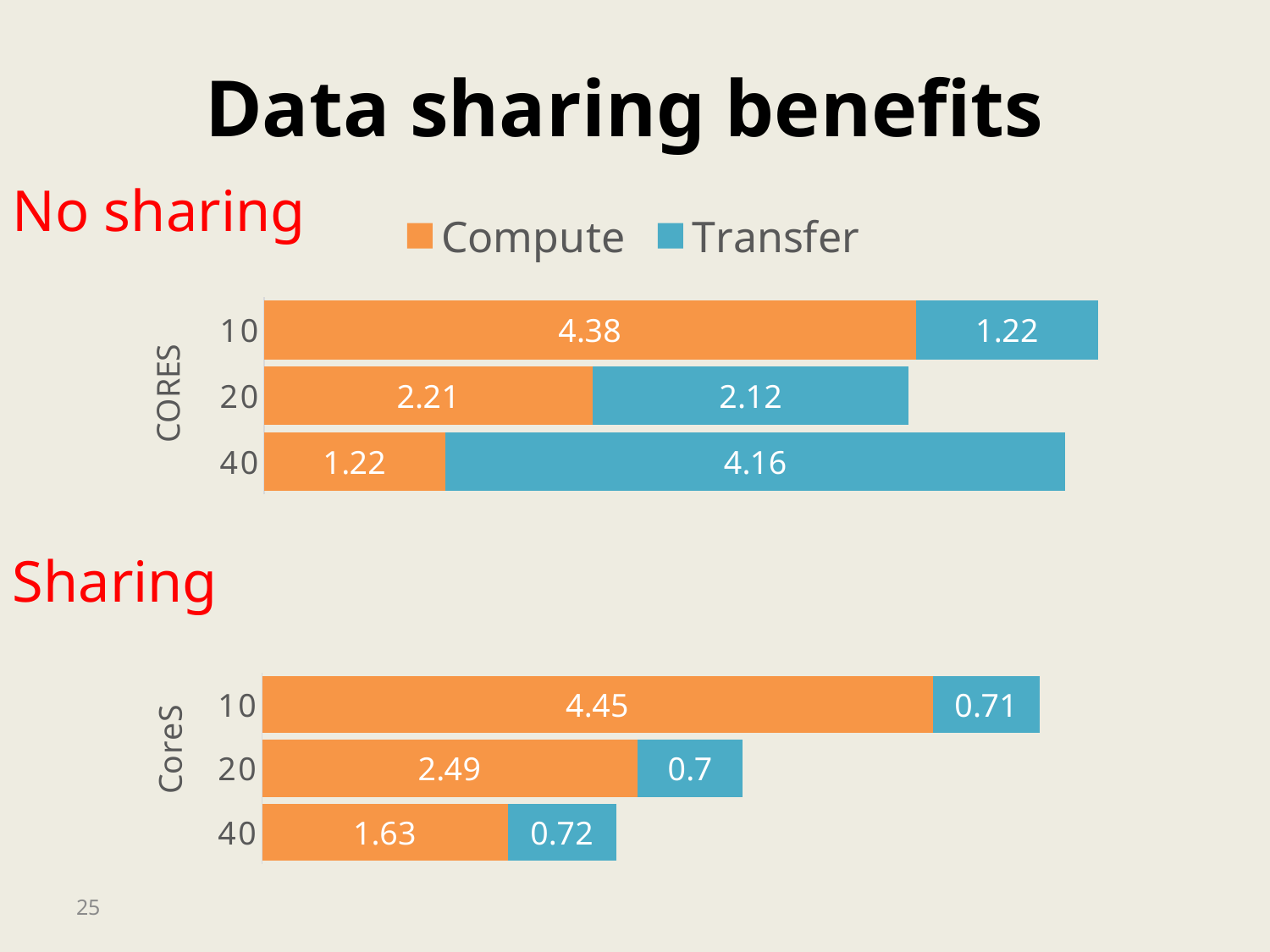
In the "No sharing" chart, is the Compute value for 20 cores larger or smaller than the Compute value for 40 cores? larger In the "No sharing" chart, what is the Transfer value for 40 cores? 4.16 In the "Sharing" chart, what is the Transfer value for 20 cores? 0.7 In the "No sharing" chart, what is the difference between the Transfer value for 40 cores and the Transfer value for 10 cores? 2.94 In the "No sharing" chart, what is the Compute value for 10 cores? 4.38 In the "Sharing" chart, which core count has the lowest Compute value? 40 In the "No sharing" chart, which core count has the highest Transfer value? 40 In the "Sharing" chart, what is the Compute value for 40 cores? 1.63 In the "Sharing" chart, what is the total of the stacked bar for 20 cores? 3.19 How many series does the legend list? 2 What kind of chart is the "Sharing" chart? stacked bar chart In the "No sharing" chart, what is the total of the stacked bar for 10 cores? 5.6